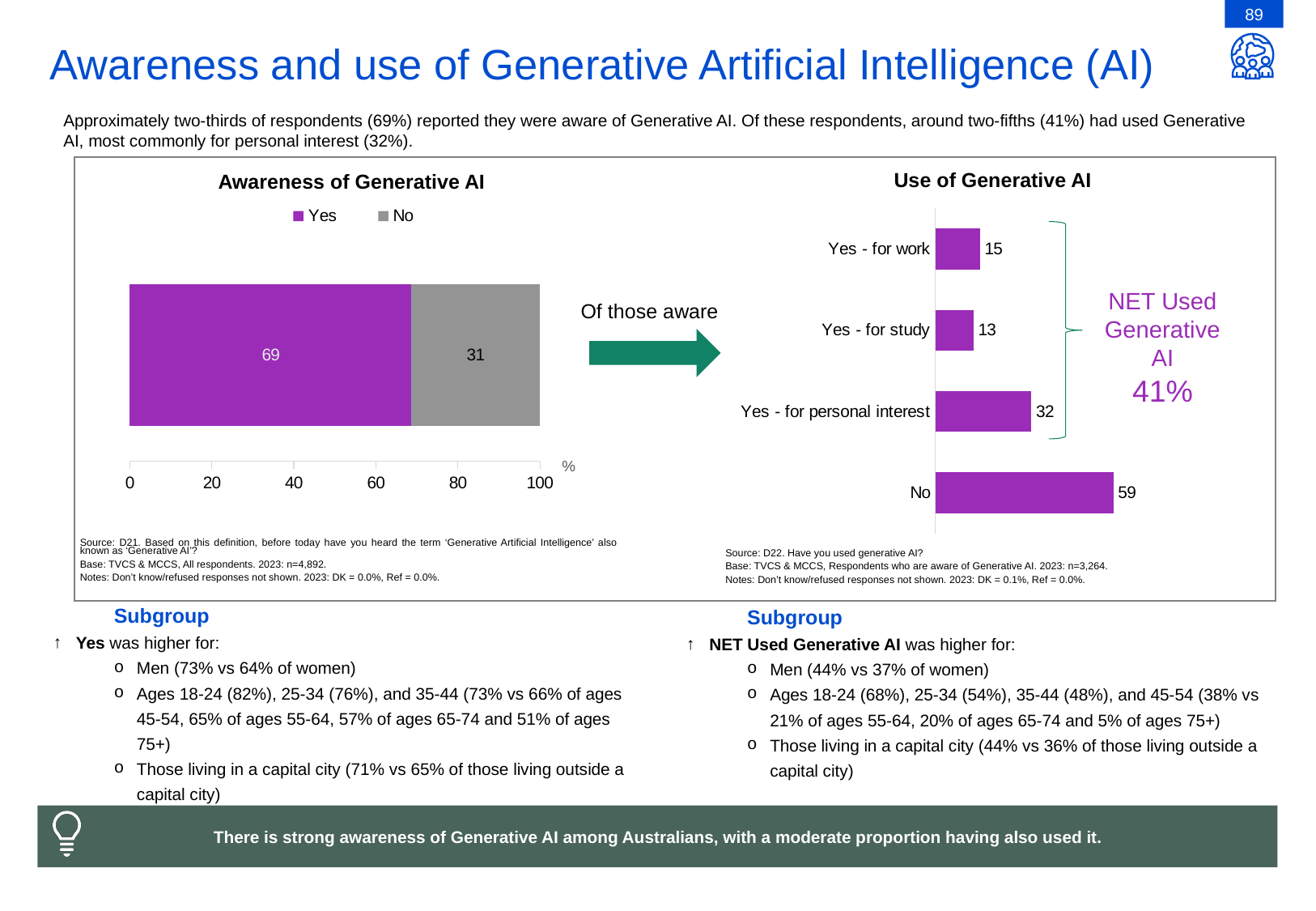
In the 'Use of Generative AI' chart, what is the value for 'Yes - for study'? 13 In the 'Awareness of Generative AI' chart, what is the value for Yes? 69 In the 'Awareness of Generative AI' chart, what is the value for No? 31 In the 'Use of Generative AI' chart, what is the value for 'Yes - for work'? 15 In the 'Use of Generative AI' chart, what is the value for 'Yes - for personal interest'? 32 In the 'Awareness of Generative AI' chart, how many series does the legend list? 2 In the 'Use of Generative AI' chart, which category has the highest value? No In the 'Awareness of Generative AI' chart, what is the difference between the Yes and No values? 38 In the 'Use of Generative AI' chart, which category has the lowest value? Yes - for study In the 'Use of Generative AI' chart, how many categories are shown? 4 In the 'Awareness of Generative AI' chart, what is the total of the stacked bar? 100 What kind of chart is the 'Use of Generative AI' chart? Bar chart